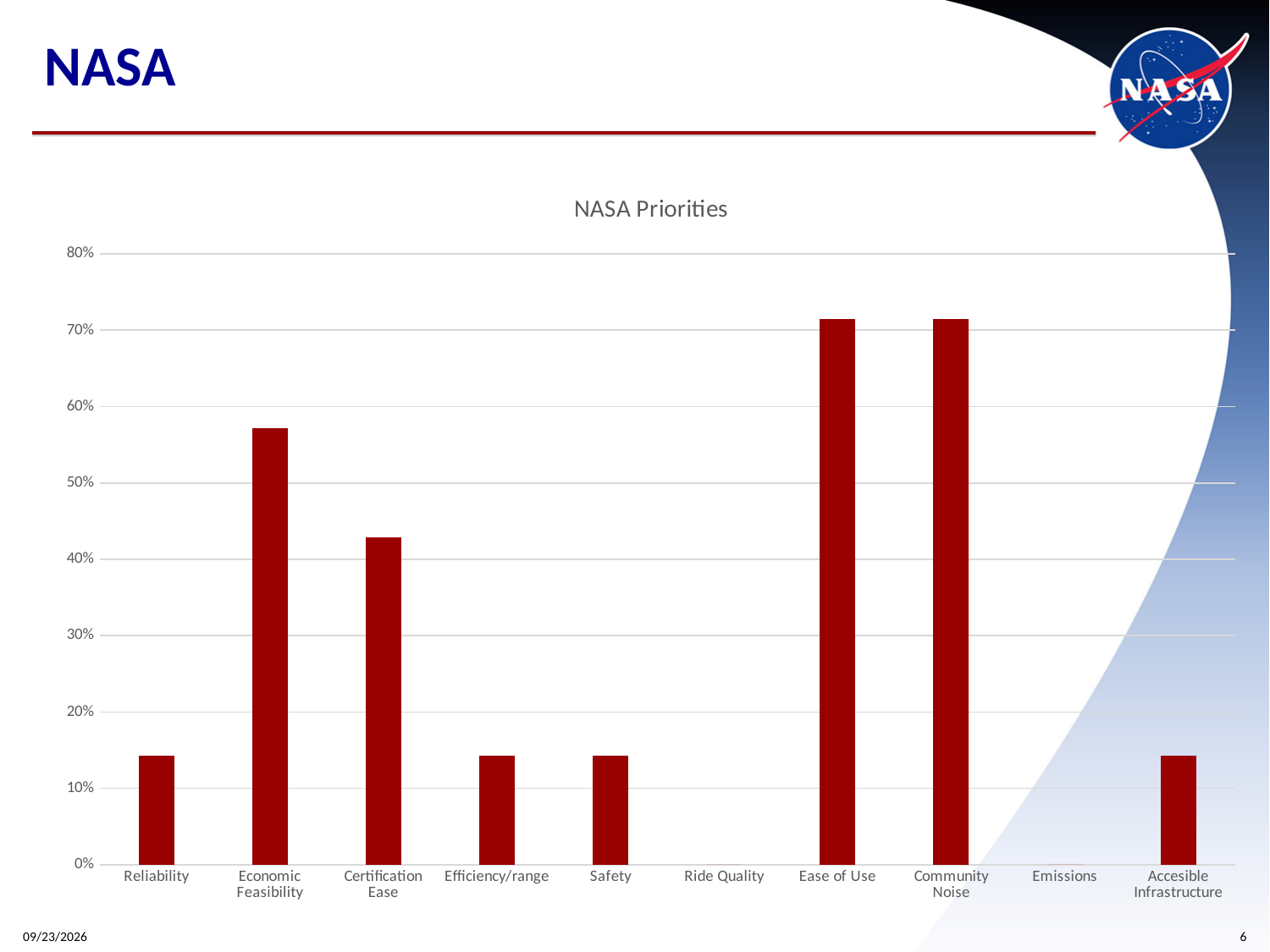
Is the value for Community Noise greater or less than 80%? less What is the title of the chart? NASA Priorities Is the value for Reliability greater or less than 20%? less Which has the larger value, Economic Feasibility or Certification Ease? Economic Feasibility What type of chart is shown on the slide? bar chart How many categories are shown on the x axis of the chart? 10 Which has the larger value, Certification Ease or Accesible Infrastructure? Certification Ease Is the value for Economic Feasibility greater or less than 50%? greater Which two categories show no bar at all in the chart? Ride Quality and Emissions Which has the larger value, Safety or Ease of Use? Ease of Use